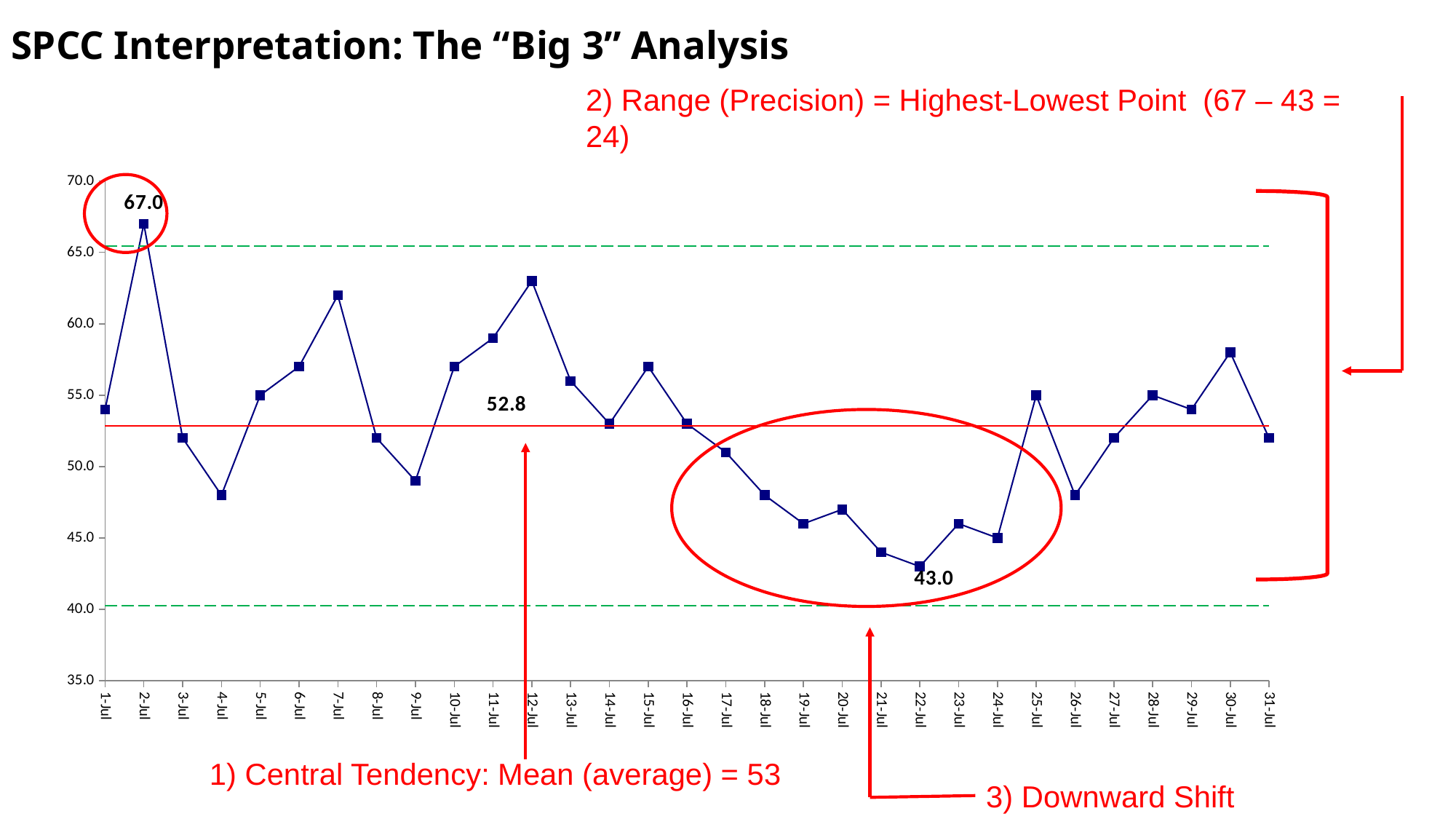
What is the difference between the highest value (2-Jul) and the lowest value (22-Jul)? 24 Which date has the lowest plotted value? 22-Jul What value is labelled on the horizontal red mean line? 52.8 Is the value for 4-Jul greater or less than 50.0? less What is the value plotted for 2-Jul? 67.0 Is the value for 7-Jul greater or less than 60.0? greater What is the value plotted for 22-Jul? 43.0 Which date has the highest plotted value? 2-Jul How many data points are plotted on the chart? 31 Which is larger, the value for 2-Jul or the value for 22-Jul? 2-Jul Do the values rise or fall from 16-Jul to 22-Jul? fall What kind of chart is shown on the slide? line chart